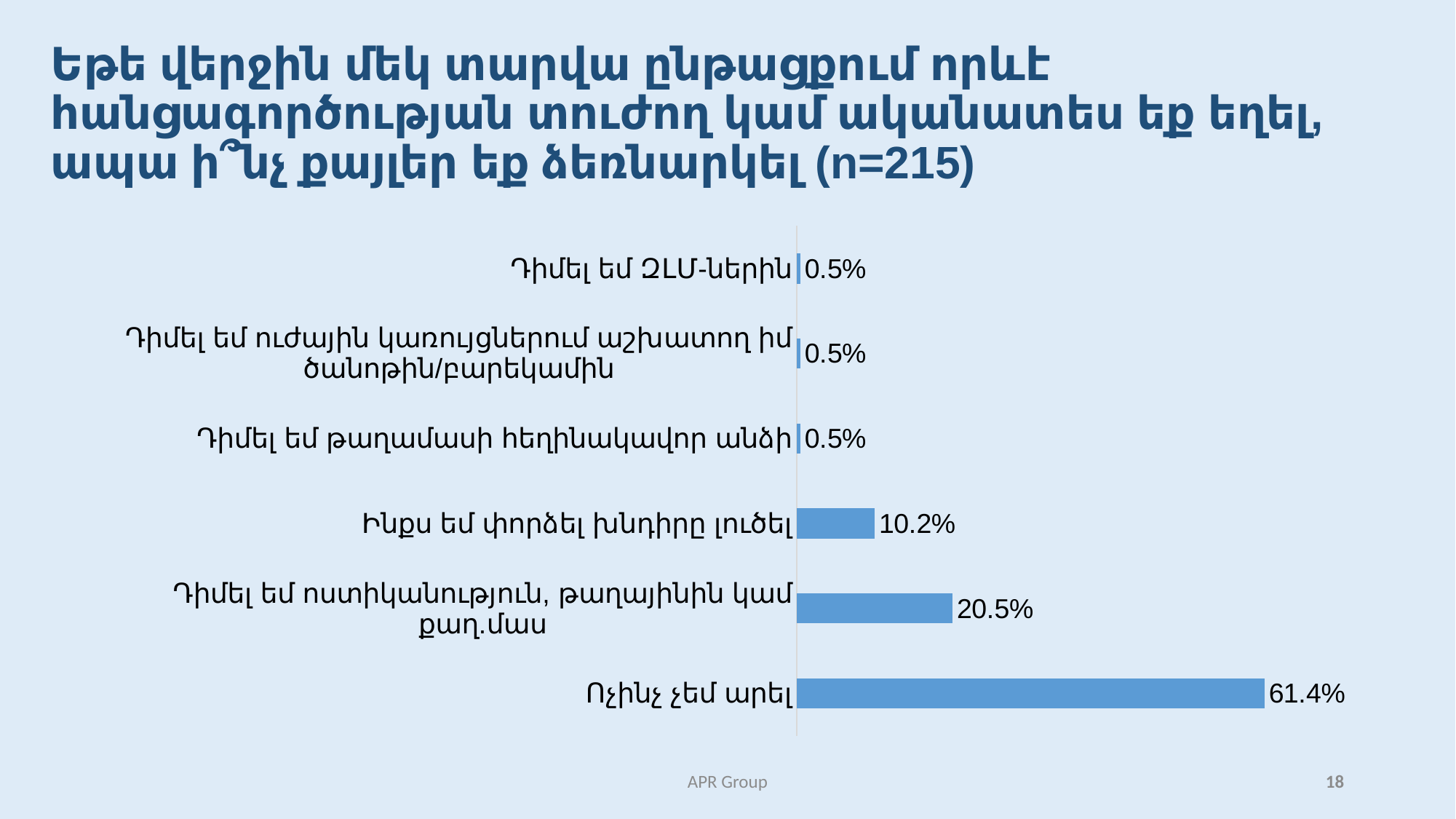
What type of chart is shown on the slide? bar chart What sample size (n) is stated in the slide title? n=215 What is the difference between the values for "Ոչինչ չեմ արել" and "Դիմել եմ ոստիկանություն, թաղայինին կամ քաղ.մաս"? 40.9% What is the value for "Դիմել եմ ոստիկանություն, թաղայինին կամ քաղ.մաս"? 20.5% Which category has the highest value? Ոչինչ չեմ արել How many categories are plotted in the chart? 6 What is the difference between the values for "Դիմել եմ ոստիկանություն, թաղայինին կամ քաղ.մաս" and "Ինքս եմ փորձել խնդիրը լուծել"? 10.3% Which is larger: the value for "Ինքս եմ փորձել խնդիրը լուծել" or the value for "Դիմել եմ թաղամասի հեղինակավոր անձի"? Ինքս եմ փորձել խնդիրը լուծել What is the value for "Ինքս եմ փորձել խնդիրը լուծել"? 10.2% What is the value for "Ոչինչ չեմ արել"? 61.4% What is the value for "Դիմել եմ ԶԼՄ-ներին"? 0.5% How many categories have a value of 0.5%? 3